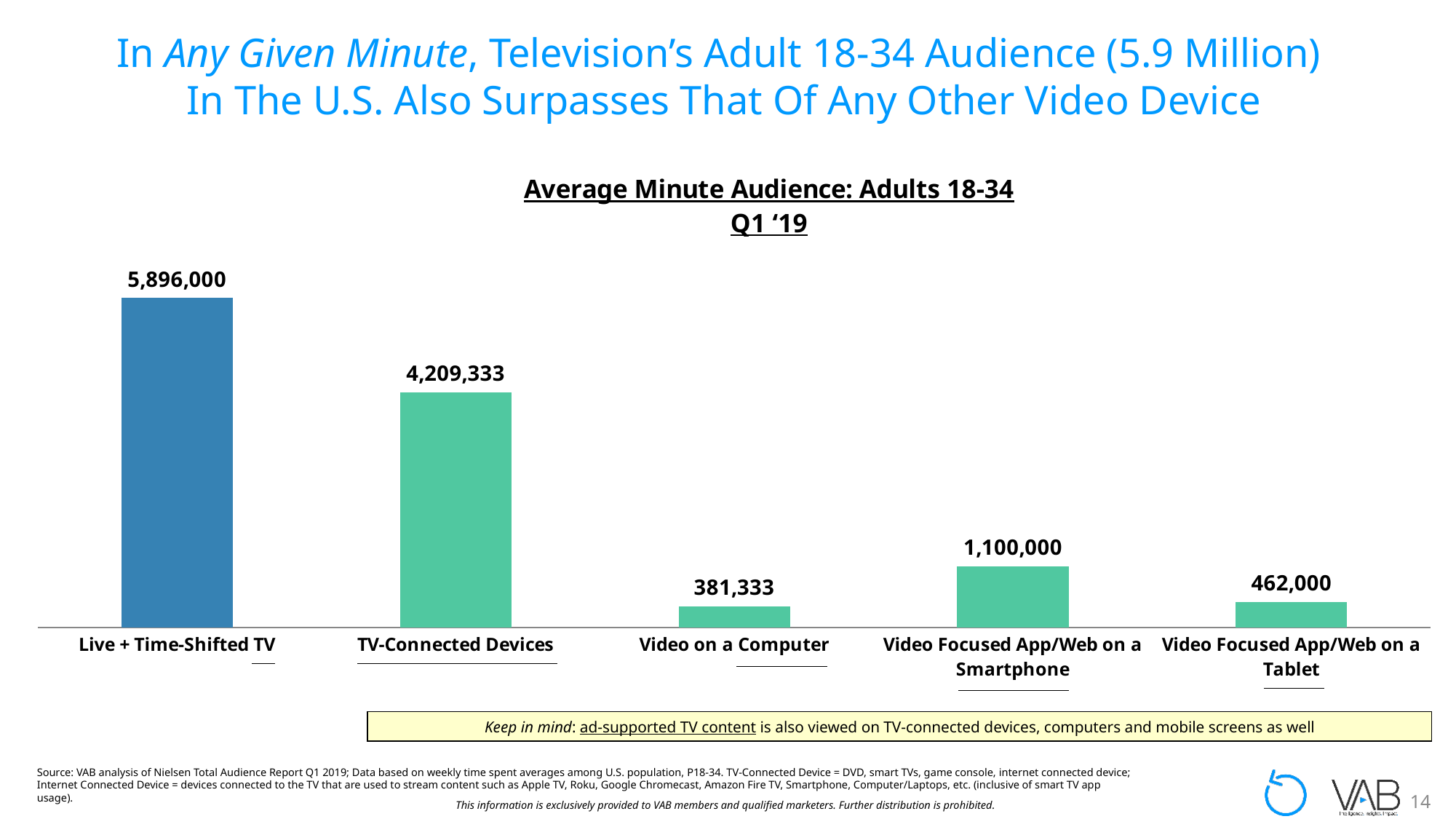
What is the average minute audience for Video Focused App/Web on a Tablet? 462,000 How many categories are shown in the chart? 5 Which category has the lowest average minute audience? Video on a Computer What is the average minute audience for Live + Time-Shifted TV? 5,896,000 What is the average minute audience for Video on a Computer? 381,333 What is the average minute audience for TV-Connected Devices? 4,209,333 Which category has the highest average minute audience? Live + Time-Shifted TV What is the average minute audience for Video Focused App/Web on a Smartphone? 1,100,000 What type of chart is shown on the slide? Bar chart Which is larger, the audience for Video Focused App/Web on a Tablet or for Video on a Computer? Video Focused App/Web on a Tablet What is the difference between the Live + Time-Shifted TV audience and the TV-Connected Devices audience? 1,686,667 What is the difference between the Smartphone and Tablet video focused app/web audiences? 638,000